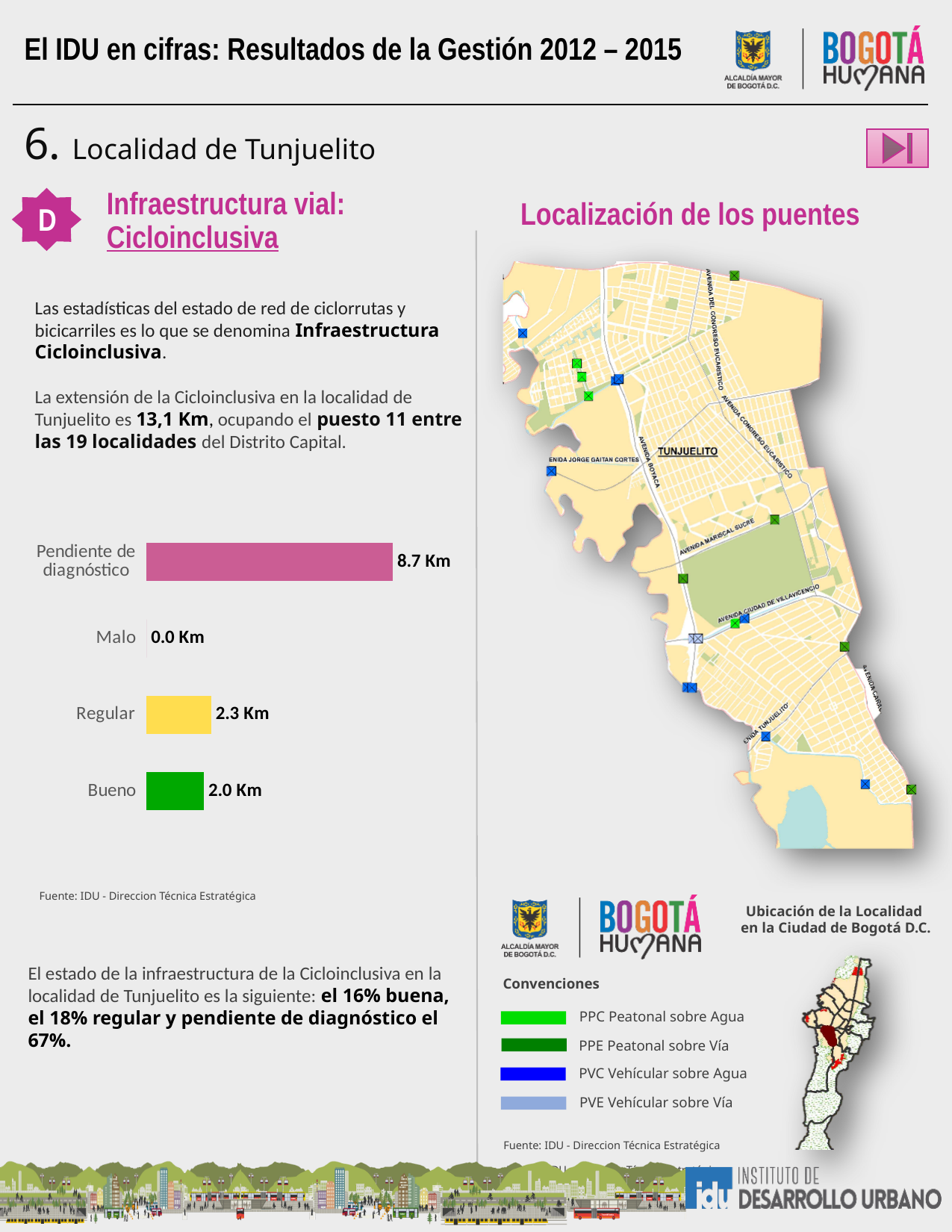
Which is larger, the value for Regular or the value for Bueno? Regular Which category has the highest value in the bar chart? Pendiente de diagnóstico What colour is the bar for Bueno? Green What is the value for Pendiente de diagnóstico in the bar chart? 8.7 Km What is the value for Bueno in the bar chart? 2.0 Km What is the difference between the values for Regular and Bueno? 0.3 Km What kind of chart is used to show the state of the Cicloinclusiva infrastructure? Bar chart How many categories are shown in the bar chart? 4 What is the value for Regular in the bar chart? 2.3 Km Which category has the lowest value in the bar chart? Malo What is the value for Malo in the bar chart? 0.0 Km What is the difference between the values for Pendiente de diagnóstico and Regular? 6.4 Km